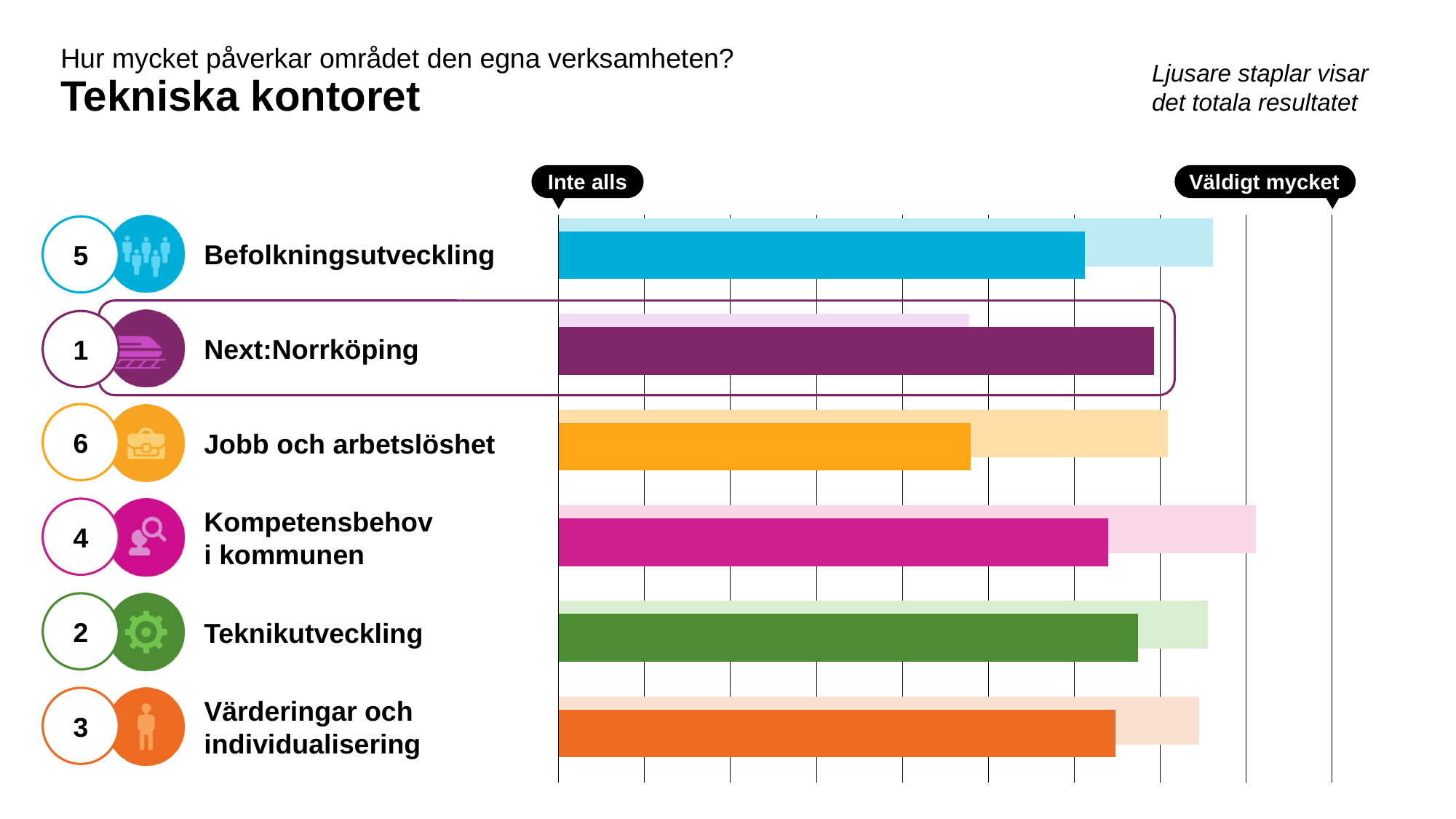
What rank number is shown in the circle next to Next:Norrköping? 1 What rank number is shown in the circle next to Jobb och arbetslöshet? 6 Which category has the longest light bar (total result)? Kompetensbehov i kommunen Which has the longer dark bar, Kompetensbehov i kommunen or Jobb och arbetslöshet? Kompetensbehov i kommunen What kind of chart is shown on the slide? bar chart What is the label at the right end of the chart's axis? Väldigt mycket How many categories (areas) are shown in the chart? 6 Which category has the shortest dark bar? Jobb och arbetslöshet Which has the longer dark bar, Teknikutveckling or Befolkningsutveckling? Teknikutveckling Which category has the shortest light bar (total result)? Next:Norrköping For Next:Norrköping, is the dark bar longer or shorter than the light bar? longer Which category has the longest dark bar? Next:Norrköping